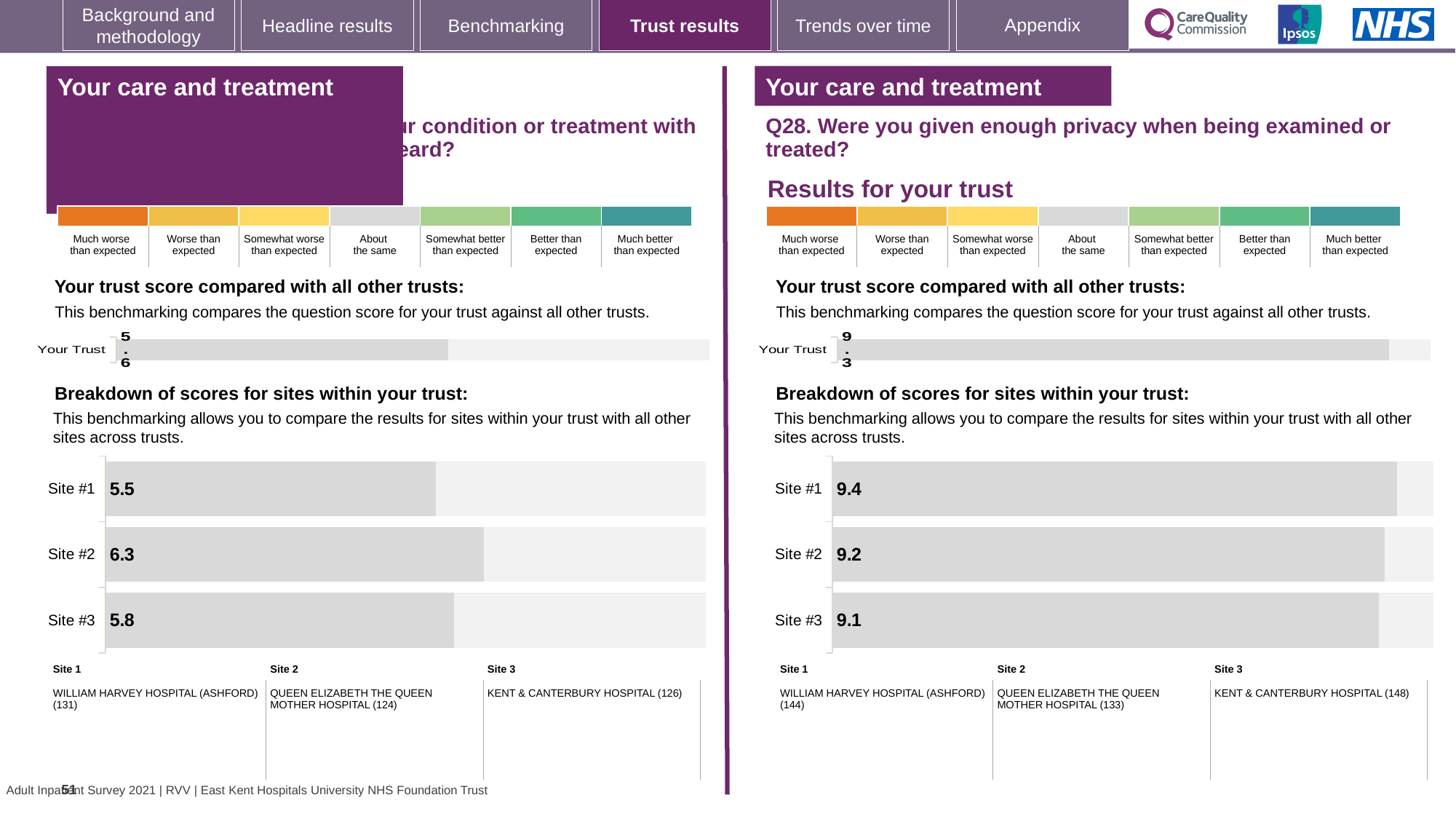
On the right-hand Q28 site breakdown chart, which site has the highest score? Site #1 On the right-hand Q28 site breakdown chart, what is the difference between the scores for Site #1 and Site #3? 0.3 On the right-hand chart for Q28 (privacy when being examined or treated), what is the score for Site #1? 9.4 How many sites are shown in the right-hand Q28 site breakdown chart? 3 What type of chart is used for the site breakdown on the left-hand side of the slide? Bar chart On the right-hand Q28 chart, what is the 'Your Trust' score compared with all other trusts? 9.3 On the left-hand site breakdown chart, what is the difference between the scores for Site #2 and Site #1? 0.8 On the left-hand site breakdown chart, which site has the highest score? Site #2 On the left-hand chart, what is the 'Your Trust' score compared with all other trusts? 5.6 On the left-hand chart (breakdown of scores for sites), what is the score for Site #2? 6.3 On the left-hand site breakdown chart, which site has the lowest score? Site #1 On the right-hand chart for Q28, what is the score for Site #3? 9.1